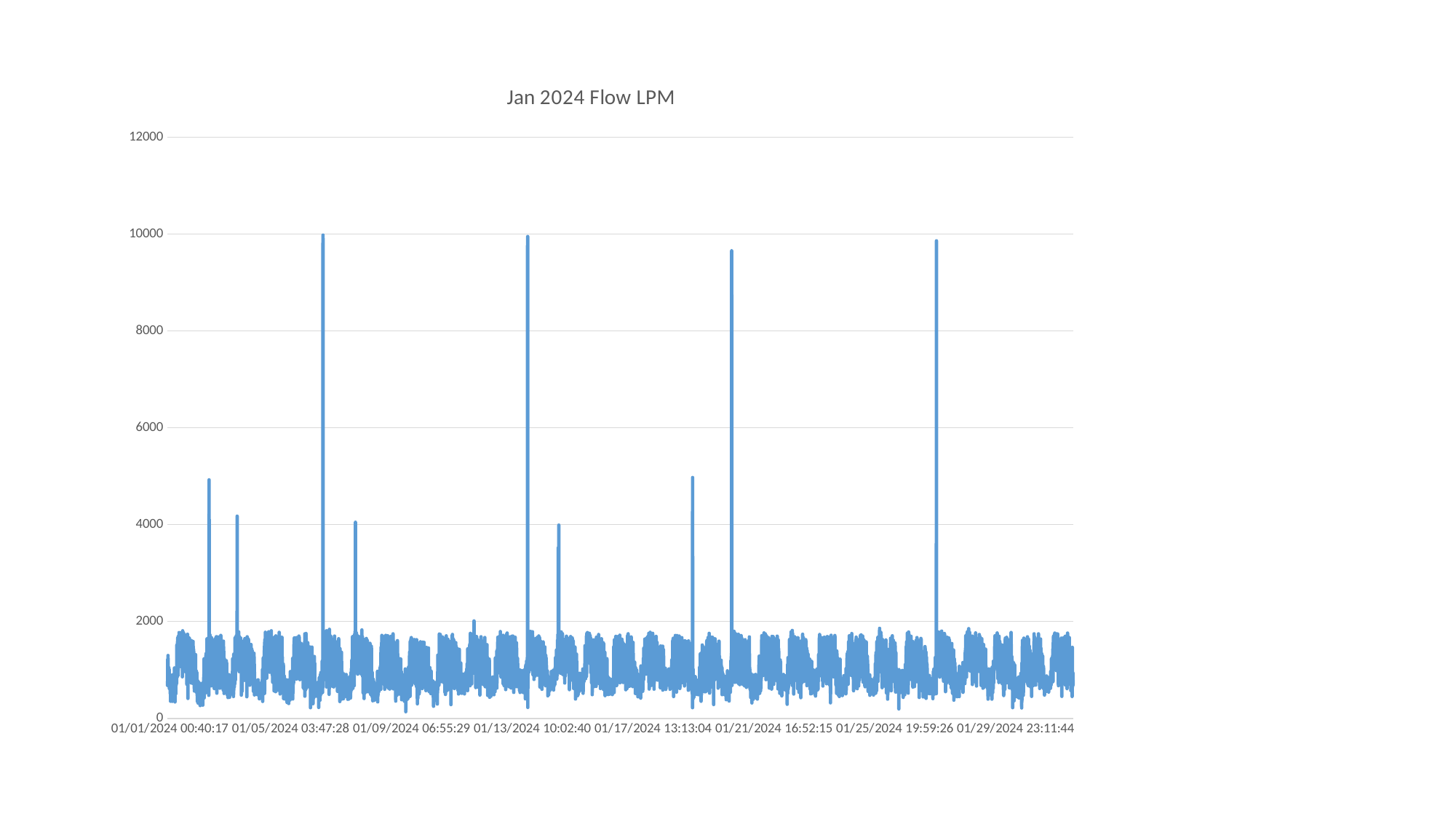
Is the typical baseline level of the line greater or less than 2000? less Is the spike near 01/05/2024 greater or less than 6000? greater Does the line ever reach a value greater than 12000? no Ignoring the spikes, does the baseline of the line rise, fall, or stay roughly flat across January? roughly flat How many spikes rise above 8000? 4 What is the last date label on the horizontal axis? 01/29/2024 23:11:44 What is the highest value shown on the vertical axis? 12000 How many date labels are shown along the horizontal axis? 8 What kind of chart is shown on the slide? line chart What is the first date label on the horizontal axis? 01/01/2024 00:40:17 What is the title of the chart? Jan 2024 Flow LPM